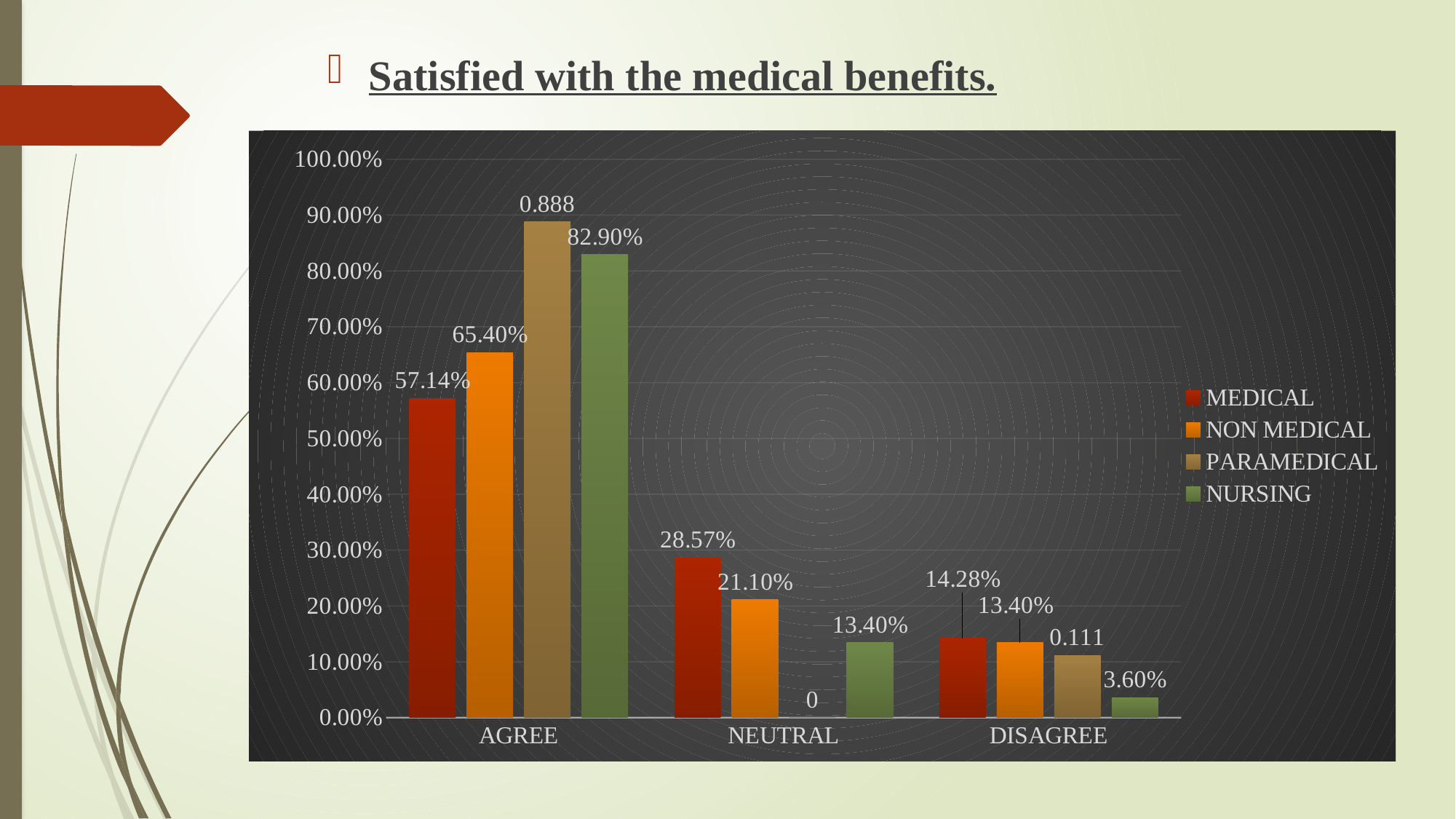
What is the value for MEDICAL in the AGREE category? 57.14% Which series has the lowest value in the NEUTRAL category? PARAMEDICAL How many categories are shown on the x axis? 3 How many series does the legend list? 4 What type of chart is shown on the slide? bar chart What is the value for NON MEDICAL in the AGREE category? 65.40% Which series has the highest value in the NEUTRAL category? MEDICAL What is the value for NURSING in the DISAGREE category? 3.60% What is the value for NURSING in the NEUTRAL category? 13.40% What is the data label shown for PARAMEDICAL in the AGREE category? 0.888 Which is larger in the DISAGREE category: MEDICAL or NURSING? MEDICAL What is the difference between the NON MEDICAL and MEDICAL values in the AGREE category? 8.26%